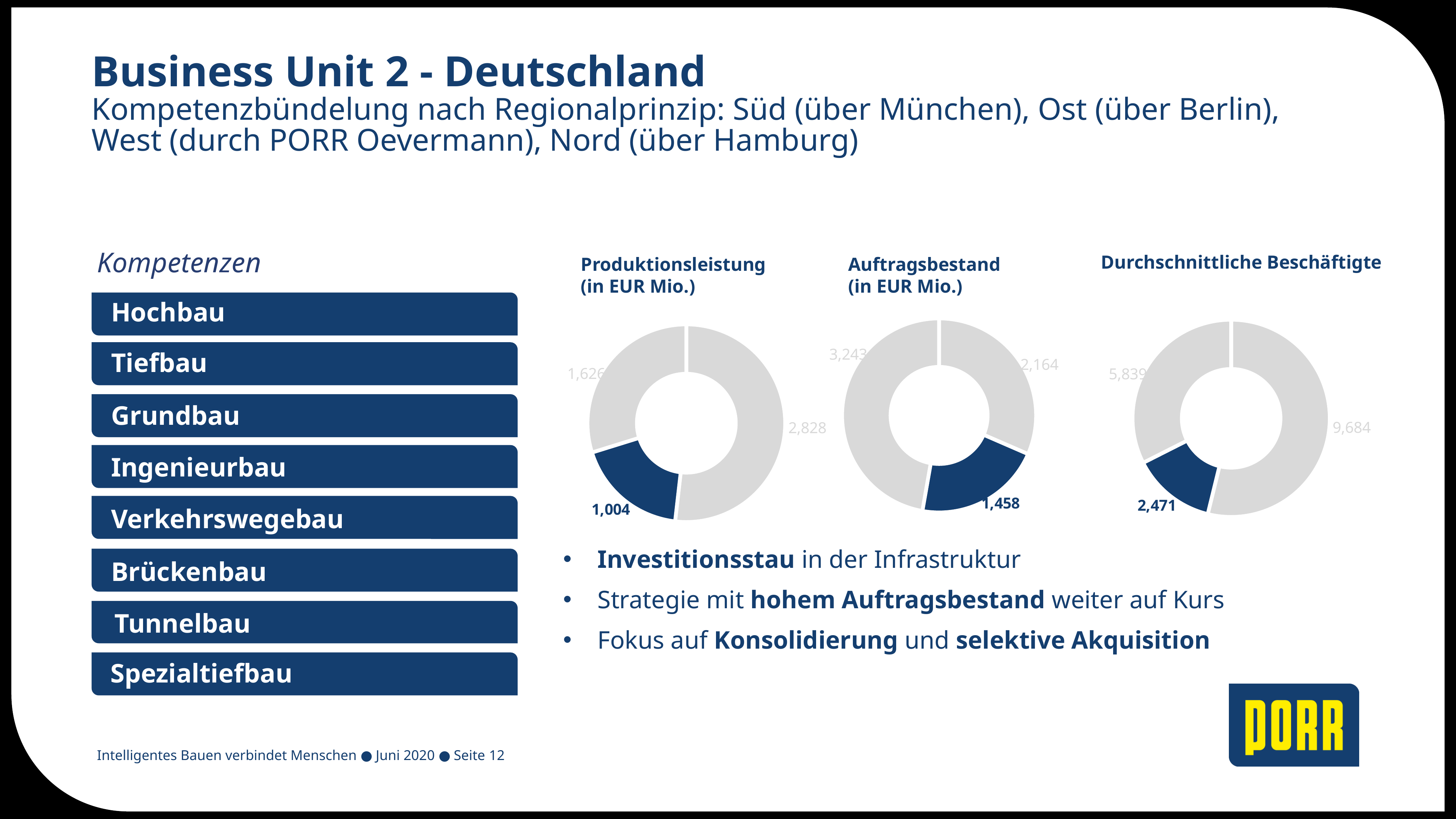
In the Auftragsbestand (in EUR Mio.) chart, what value is shown for the dark blue highlighted segment? 1,458 In the Durchschnittliche Beschäftigte chart, what is the difference between the largest segment (9,684) and the highlighted segment (2,471)? 7,213 In the Produktionsleistung (in EUR Mio.) chart, what is the largest segment value? 2,828 In the Auftragsbestand (in EUR Mio.) chart, what is the largest segment value? 3,243 What kind of chart is used for Durchschnittliche Beschäftigte? Donut chart How many segments does the Produktionsleistung (in EUR Mio.) donut chart have? 3 In the Produktionsleistung (in EUR Mio.) chart, which is larger: the segment labelled 1,626 or the segment labelled 2,828? 2,828 What unit is given in the title of the Auftragsbestand chart? EUR Mio. In the Produktionsleistung (in EUR Mio.) chart, what value is shown for the dark blue highlighted segment? 1,004 In the Durchschnittliche Beschäftigte chart, what value is shown for the dark blue highlighted segment? 2,471 In the Durchschnittliche Beschäftigte chart, what is the smallest segment value? 2,471 What is the total of all three segments in the Auftragsbestand (in EUR Mio.) chart? 6,865